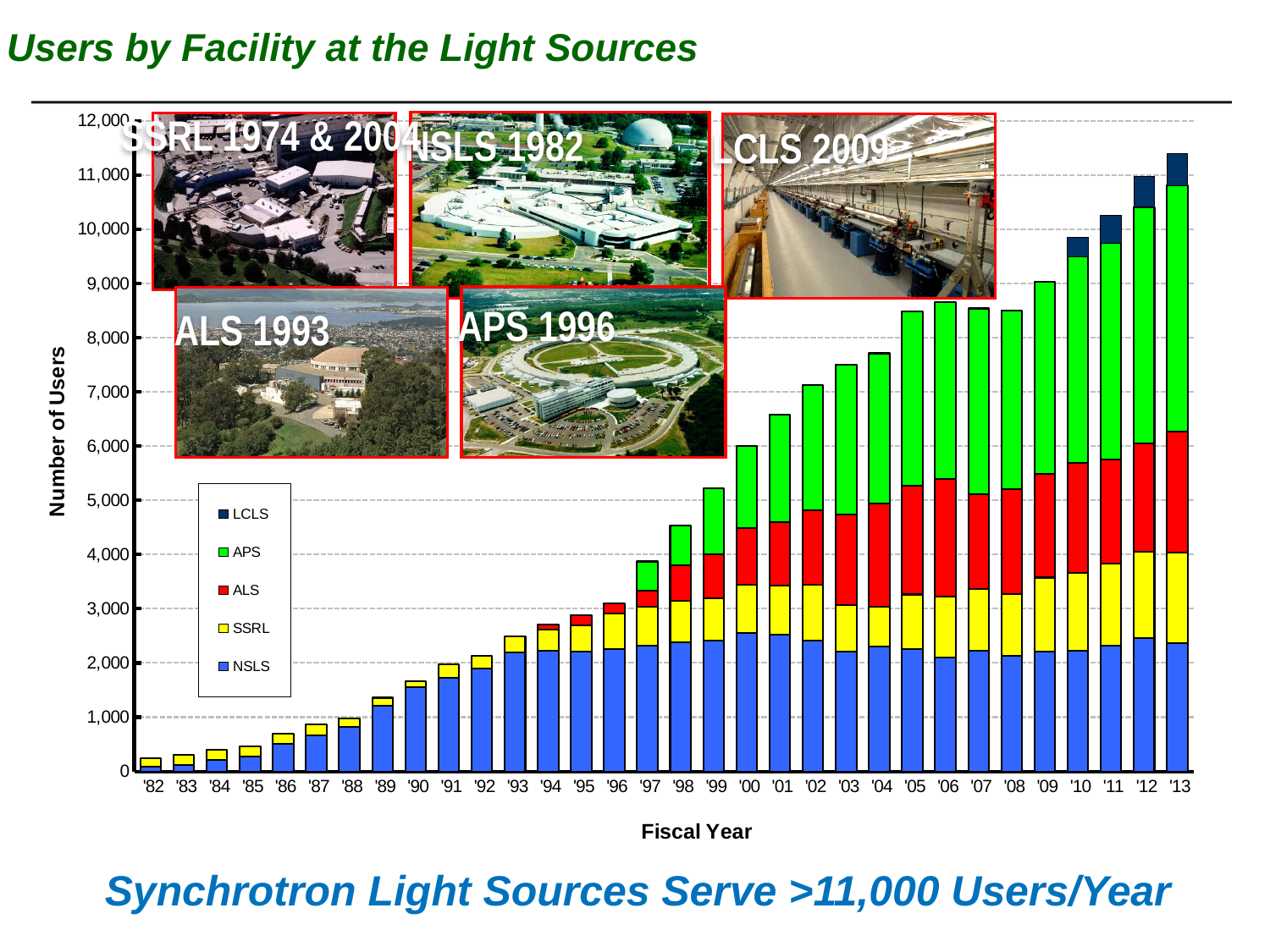
How many fiscal years are plotted along the x axis? 32 Is the total number of users in '13 greater or less than 11,000? greater Which fiscal year has the highest total number of users? '13 Is the total number of users in '05 greater or less than 8,000? greater What is the label on the y axis of the chart? Number of Users How many series does the legend list? 5 Which fiscal year has the lowest total number of users? '82 What kind of chart is shown on the slide? stacked bar chart Is the total number of users in '86 greater or less than 1,000? less Do the total number of users generally rise or fall from '82 to '13? rise Which fiscal year has a larger total number of users, '97 or '01? '01 Which series is shown in green in the chart? APS